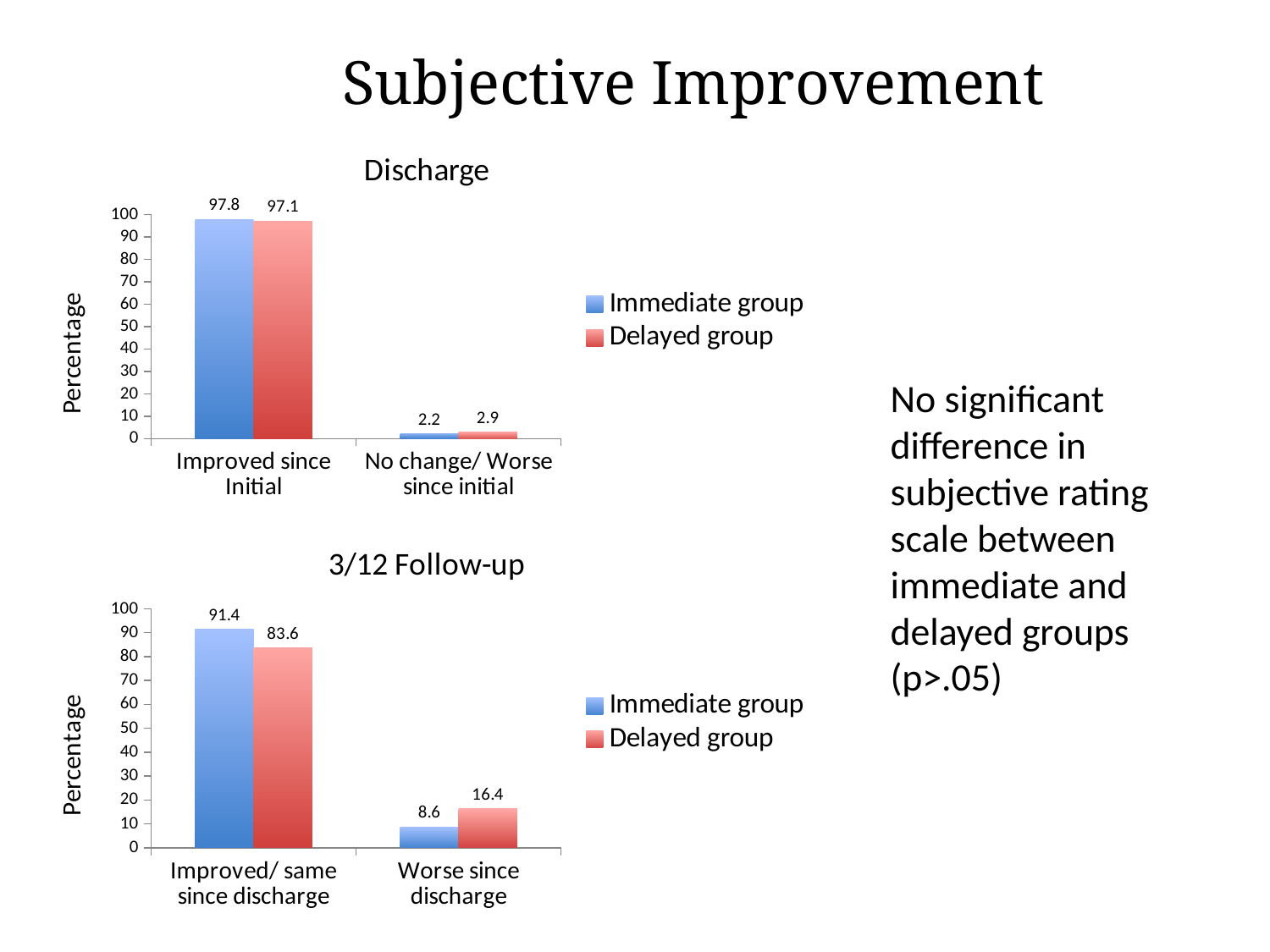
In the Discharge chart, what is the value for the Delayed group in the No change/ Worse since initial category? 2.9 How many categories are shown on the x axis of the 3/12 Follow-up chart? 2 In the Discharge chart, what is the difference between the Immediate group and the Delayed group in the Improved since Initial category? 0.7 What is the y-axis label of the 3/12 Follow-up chart? Percentage In the 3/12 Follow-up chart, what is the difference between the Delayed group and the Immediate group in the Worse since discharge category? 7.8 In the 3/12 Follow-up chart, which group has the larger value in the Improved/ same since discharge category? Immediate group How many series does the legend of the Discharge chart list? 2 In the 3/12 Follow-up chart, what is the value for the Delayed group in the Improved/ same since discharge category? 83.6 In the 3/12 Follow-up chart, what is the value for the Immediate group in the Worse since discharge category? 8.6 In the 3/12 Follow-up chart, which group has the larger value in the Worse since discharge category? Delayed group In the Discharge chart, what is the value for the Immediate group in the Improved since Initial category? 97.8 What kind of chart is the Discharge chart? Bar chart